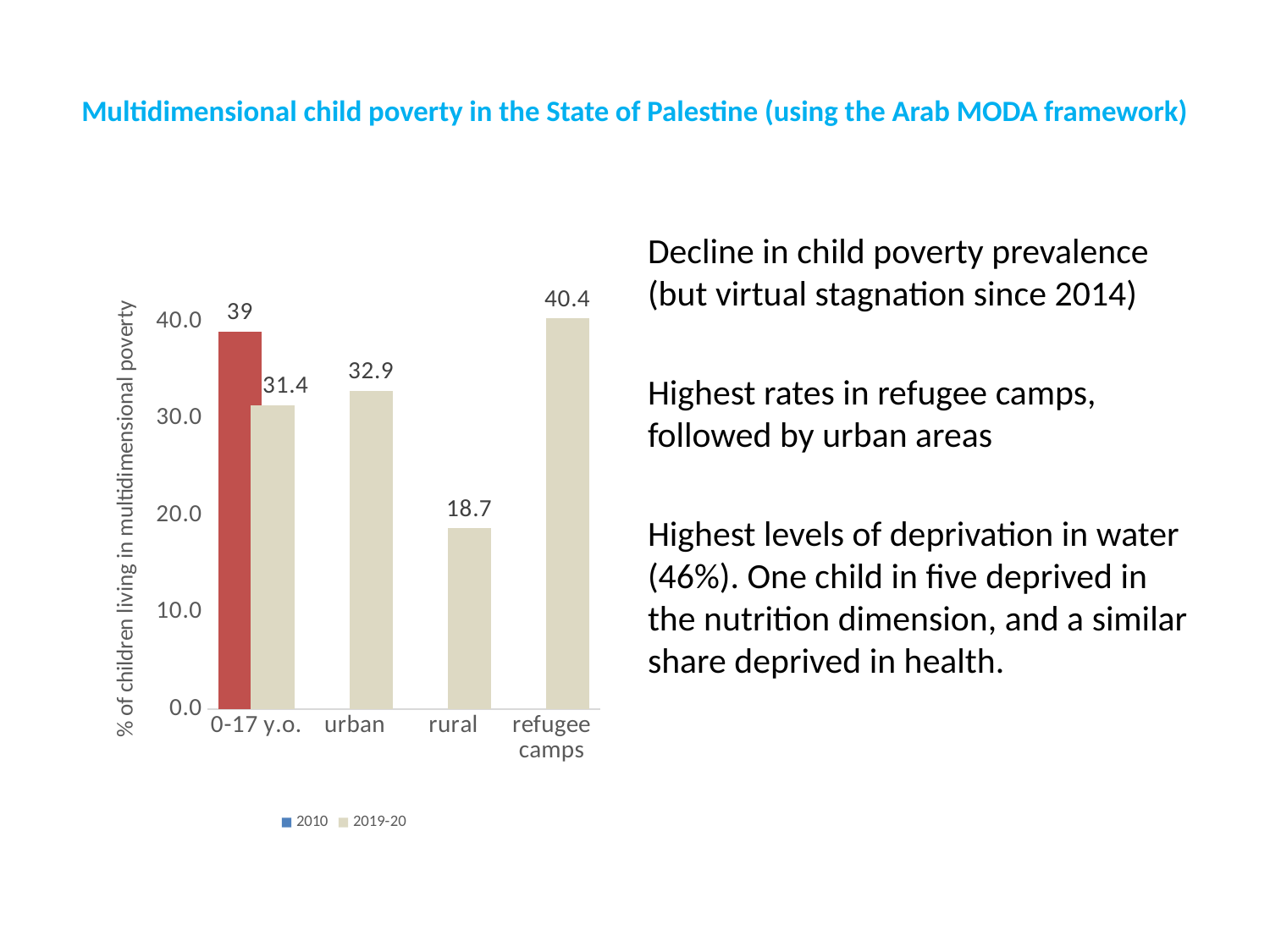
Which is larger in 2019-20, the value for urban or for 0-17 y.o.? urban What is the difference between the 2019-20 values for refugee camps and rural? 21.7 What is the difference between the 2010 and 2019-20 values for 0-17 y.o.? 7.6 What is the 2010 value for 0-17 y.o.? 39 What is the 2019-20 value for urban? 32.9 What kind of chart is shown on the slide? bar chart What is the 2019-20 value for refugee camps? 40.4 Which category has the highest 2019-20 value? refugee camps Which category has the lowest 2019-20 value? rural What is the 2019-20 value for rural? 18.7 How many categories are shown on the x axis? 4 How many series does the legend list? 2